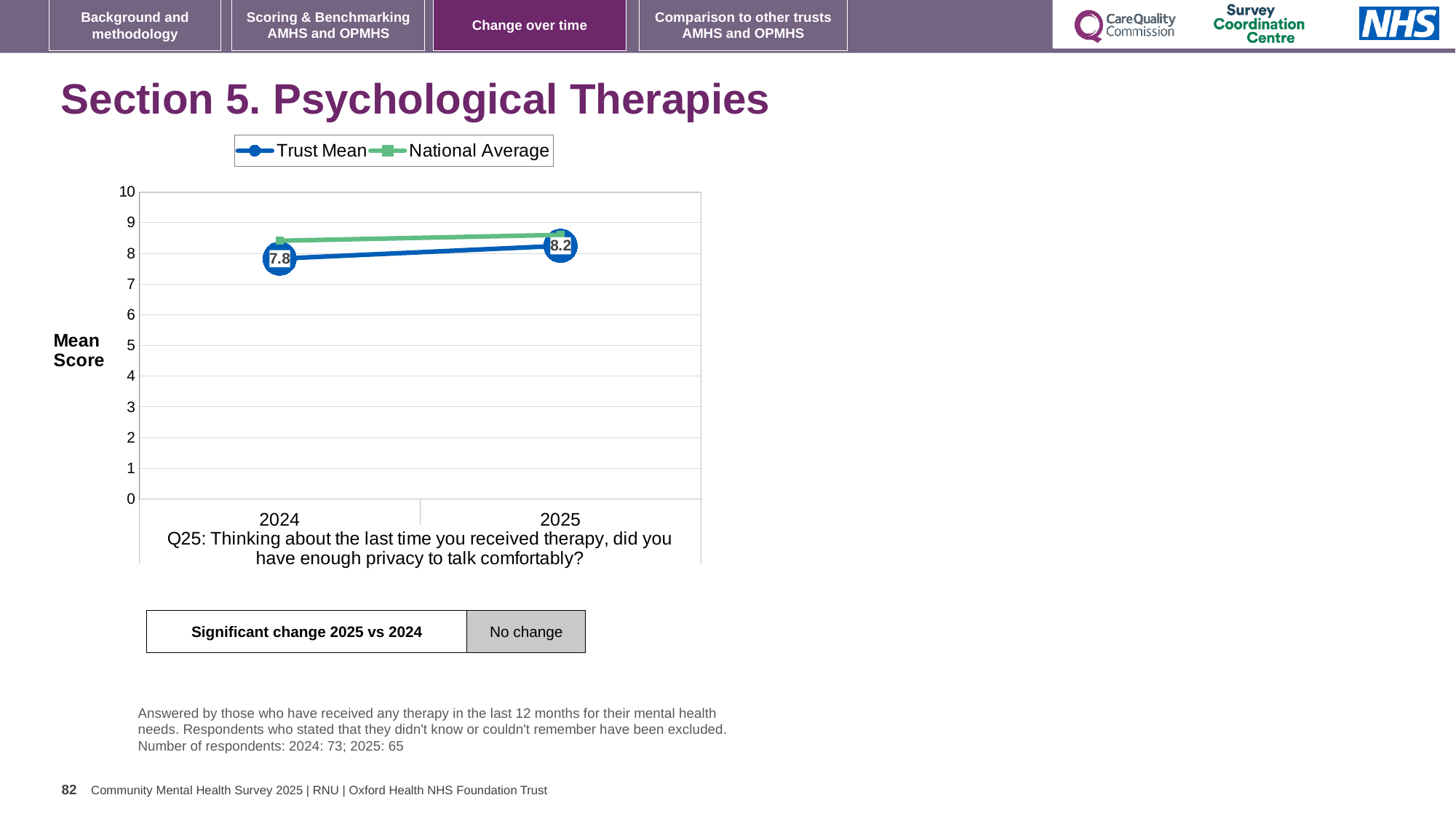
In 2024, which is higher: the Trust Mean or the National Average? National Average Is the National Average for 2024 greater or less than 8? greater Which year has the higher Trust Mean score? 2025 Does the Trust Mean rise or fall from 2024 to 2025? rise Which year has the lower Trust Mean score? 2024 What type of chart is shown on the slide? line chart By how much did the Trust Mean change from 2024 to 2025? 0.4 How many years are plotted on the x axis? 2 What is the Trust Mean score for 2025? 8.2 Is the Trust Mean for 2024 greater or less than 8? less How many series does the legend list? 2 What is the Trust Mean score for 2024? 7.8